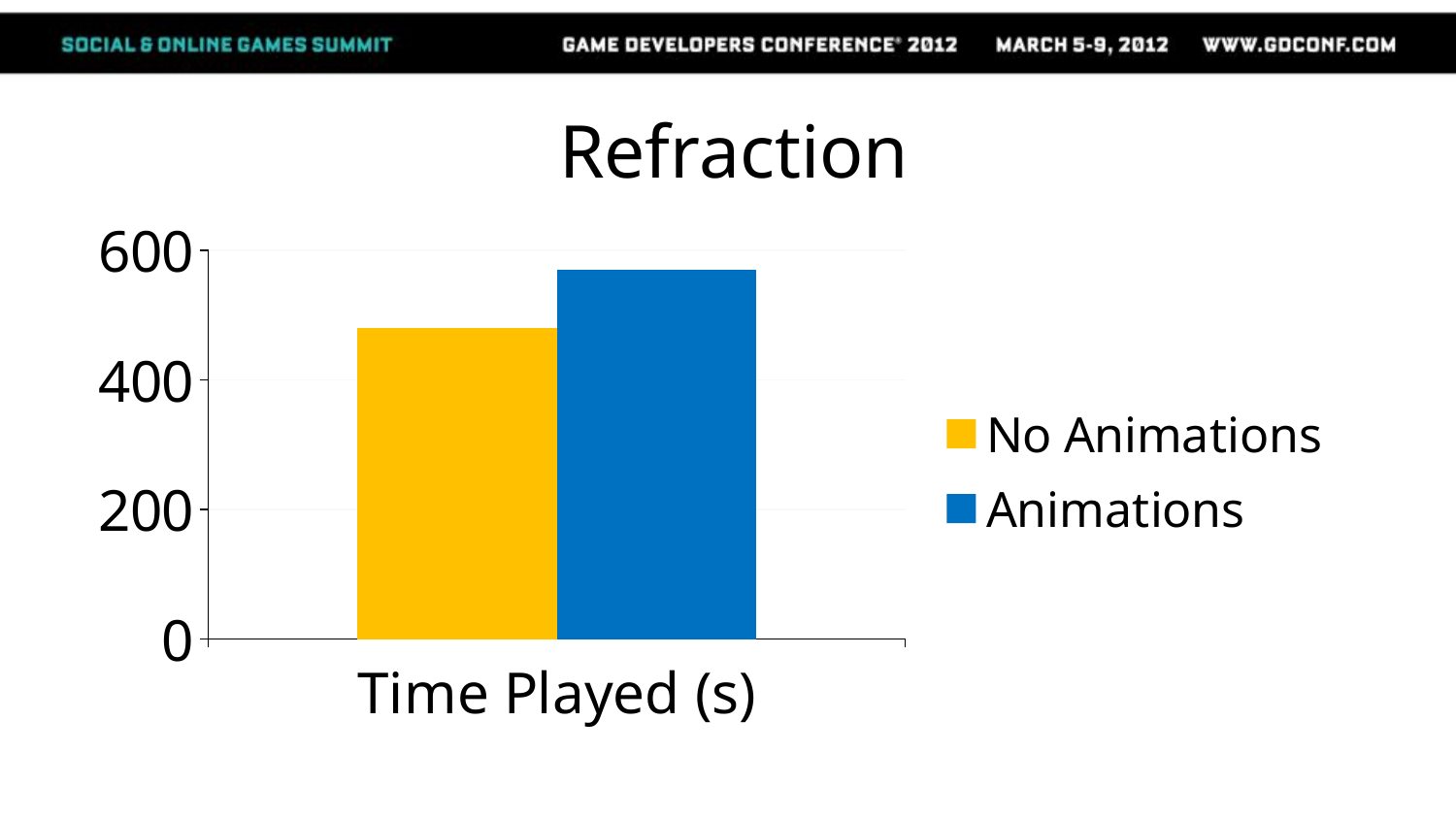
Which series has the lower value for Time Played (s)? No Animations Which series has the higher value for Time Played (s)? Animations Is the value for Animations larger or smaller than the value for No Animations? larger What is the title of the chart? Refraction Is the value for Animations greater or less than 400? greater How many series does the legend list? 2 Is the value for No Animations greater or less than 600? less How many categories are shown on the x axis? 1 What is the label of the category on the x axis? Time Played (s) What kind of chart is shown on the slide? bar chart Is the value for No Animations greater or less than 400? greater